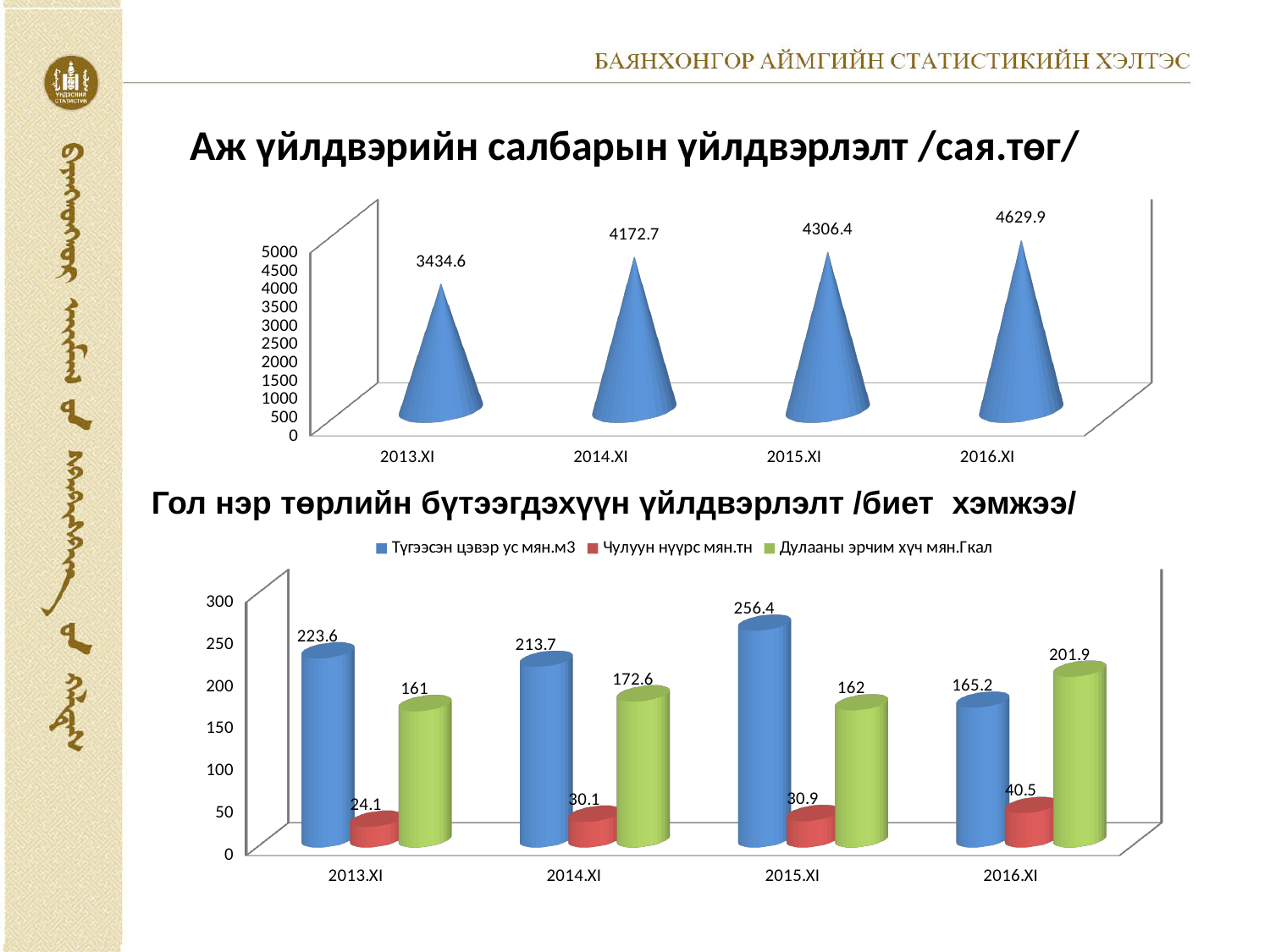
How many series does the legend of the bottom chart 'Гол нэр төрлийн бүтээгдэхүүн үйлдвэрлэлт /биет хэмжээ/' list? 3 In the bottom chart 'Гол нэр төрлийн бүтээгдэхүүн үйлдвэрлэлт /биет хэмжээ/', what is the value of 'Түгээсэн цэвэр ус мян.м3' for 2015.XI? 256.4 In the top chart 'Аж үйлдвэрийн салбарын үйлдвэрлэлт /сая.төг/', which year has the highest value? 2016.XI In the bottom chart 'Гол нэр төрлийн бүтээгдэхүүн үйлдвэрлэлт /биет хэмжээ/', which year has the lowest value for 'Түгээсэн цэвэр ус мян.м3'? 2016.XI In the bottom chart 'Гол нэр төрлийн бүтээгдэхүүн үйлдвэрлэлт /биет хэмжээ/', which is larger for 2014.XI: 'Түгээсэн цэвэр ус мян.м3' or 'Дулааны эрчим хүч мян.Гкал'? Түгээсэн цэвэр ус мян.м3 In the top chart 'Аж үйлдвэрийн салбарын үйлдвэрлэлт /сая.төг/', what is the value for 2014.XI? 4172.7 What kind of chart is the bottom chart 'Гол нэр төрлийн бүтээгдэхүүн үйлдвэрлэлт /биет хэмжээ/'? bar chart In the bottom chart 'Гол нэр төрлийн бүтээгдэхүүн үйлдвэрлэлт /биет хэмжээ/', which year has the highest value for 'Дулааны эрчим хүч мян.Гкал'? 2016.XI In the bottom chart 'Гол нэр төрлийн бүтээгдэхүүн үйлдвэрлэлт /биет хэмжээ/', what is the value of 'Чулуун нүүрс мян.тн' for 2016.XI? 40.5 In the top chart 'Аж үйлдвэрийн салбарын үйлдвэрлэлт /сая.төг/', what is the difference between the 2016.XI and 2013.XI values? 1195.3 In the top chart 'Аж үйлдвэрийн салбарын үйлдвэрлэлт /сая.төг/', do the values rise or fall from 2013.XI to 2016.XI? rise How many categories are shown on the x axis of the top chart 'Аж үйлдвэрийн салбарын үйлдвэрлэлт /сая.төг/'? 4